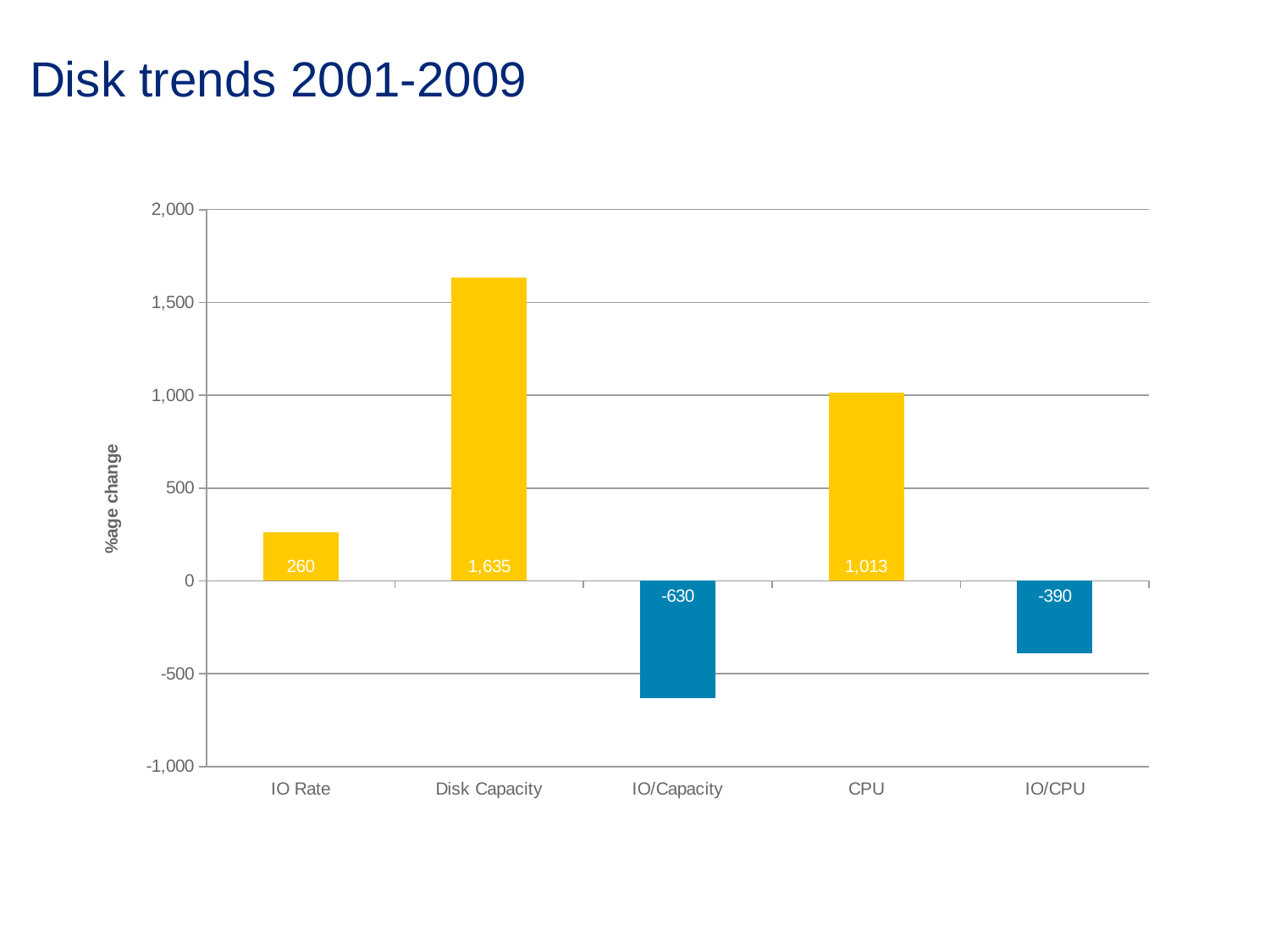
What is the value for Disk Capacity? 1,635 Is the value for IO/CPU greater or less than -500? greater Which category has the highest value? Disk Capacity What kind of chart is shown? bar chart What is the difference between the values for Disk Capacity and CPU? 622 How many categories are shown on the x axis? 5 What is the value for IO/Capacity? -630 Which is larger, the value for IO Rate or the value for CPU? CPU What is the value for CPU? 1,013 What is the value for IO Rate? 260 Which category has the lowest value? IO/Capacity What is the label of the vertical axis? %age change